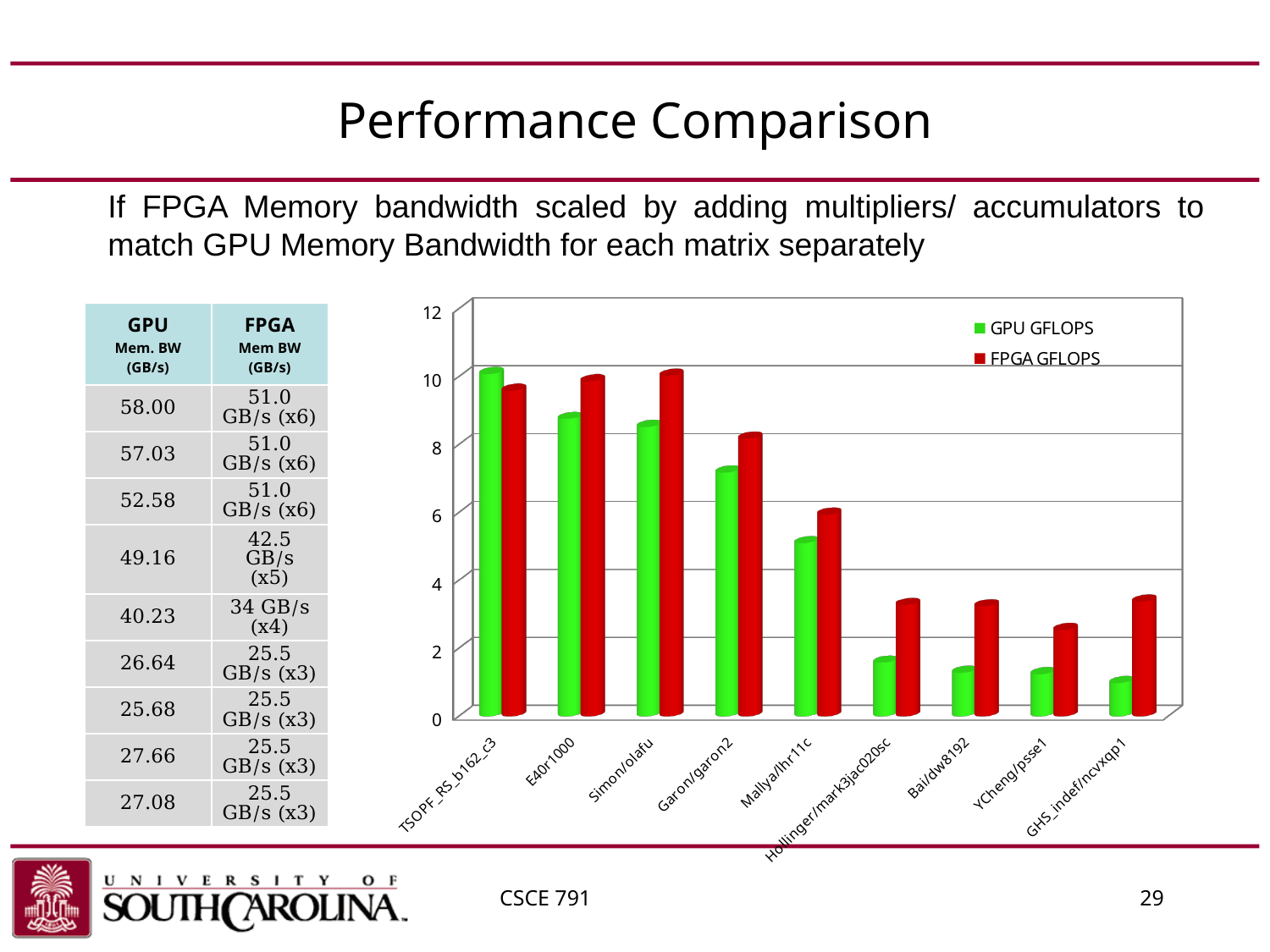
For Hollinger/mark3jac020sc, which is larger: GPU GFLOPS or FPGA GFLOPS? FPGA GFLOPS How many matrices (categories) are plotted along the x axis of the chart? 9 How many series does the chart legend list? 2 For TSOPF_RS_b162_c3, which is larger: GPU GFLOPS or FPGA GFLOPS? GPU GFLOPS Do the GPU GFLOPS values generally rise or fall moving left to right along the x axis? fall Is the FPGA GFLOPS value for Bai/dw8192 greater or less than 2? greater Which matrix has the highest GPU GFLOPS value in the chart? TSOPF_RS_b162_c3 What type of chart is shown on the slide? bar chart Which series is shown in green in the chart? GPU GFLOPS Is the GPU GFLOPS value for Garon/garon2 greater or less than 8? less Which matrix has the lowest GPU GFLOPS value in the chart? GHS_indef/ncvxqp1